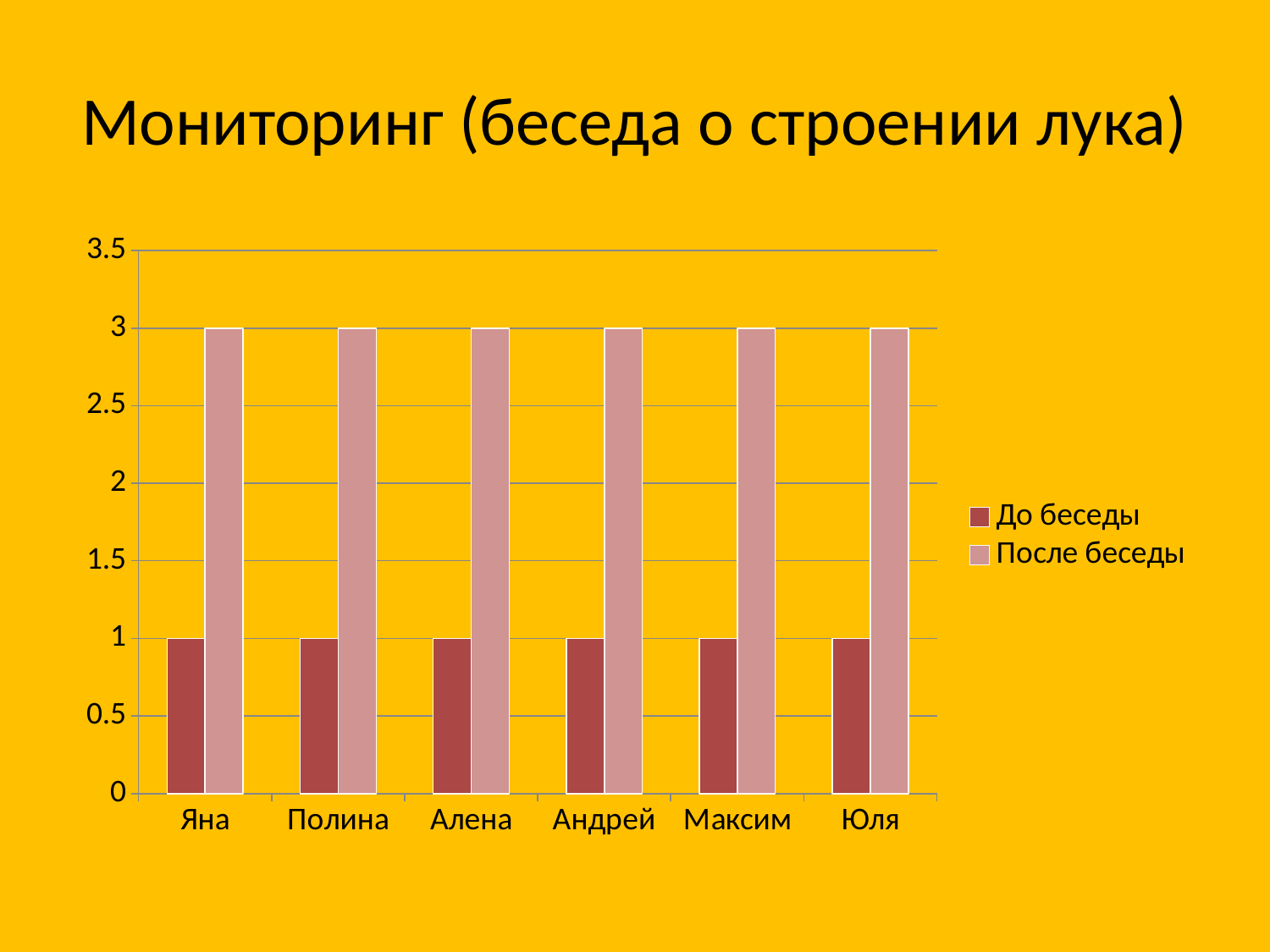
How many series does the legend list? 2 What is the difference between the 'После беседы' and 'До беседы' values for Юля? 2 How many categories (children) are shown on the x axis? 6 What kind of chart is shown on the slide? Bar chart What is the value for Яна in the 'До беседы' series? 1 Which is larger for Полина: the 'До беседы' value or the 'После беседы' value? После беседы What is the value for Андрей in the 'После беседы' series? 3 Is the 'После беседы' value for Алена greater or less than 2? greater What is the value for Максим in the 'До беседы' series? 1 What is the title of the chart? Мониторинг (беседа о строении лука) What is the value for Яна in the 'После беседы' series? 3 Which series is shown in the lighter pink colour? После беседы